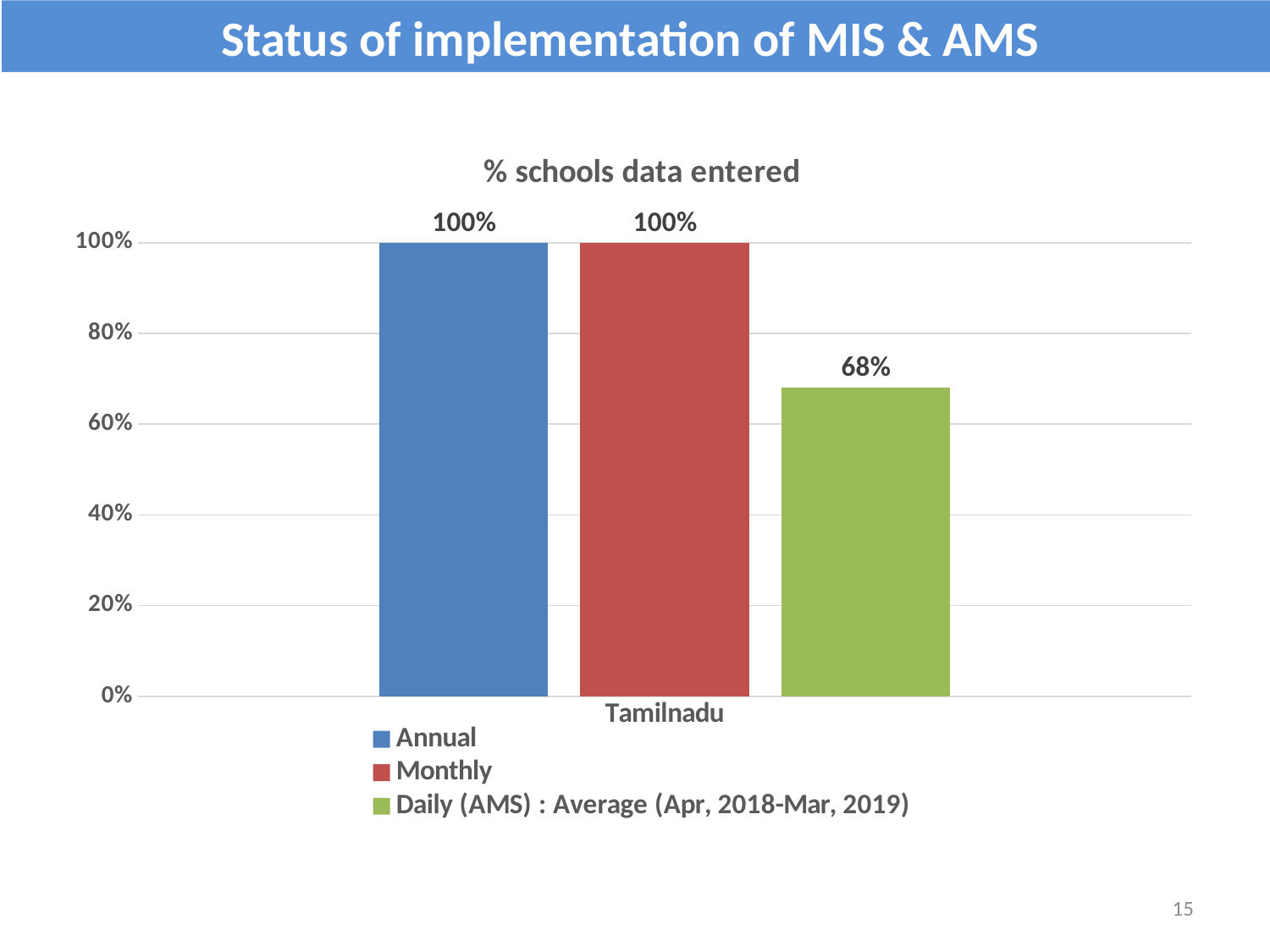
What is the difference between the Annual value and the Daily (AMS) value for Tamilnadu? 32% What is the value of the Daily (AMS) : Average (Apr, 2018-Mar, 2019) series for Tamilnadu? 68% What is the value of the Monthly series for Tamilnadu? 100% How many series does the legend list? 3 Which series has the lowest value for Tamilnadu? Daily (AMS) : Average (Apr, 2018-Mar, 2019) What colour is the bar for the Monthly series? Red Which is larger for Tamilnadu, the Monthly value or the Daily (AMS) value? Monthly What is the value of the Annual series for Tamilnadu? 100% How many categories are shown on the x axis? 1 What is the title of the chart? % schools data entered What kind of chart is shown on the slide? Bar chart Is the Daily (AMS) value for Tamilnadu greater or less than 80%? less